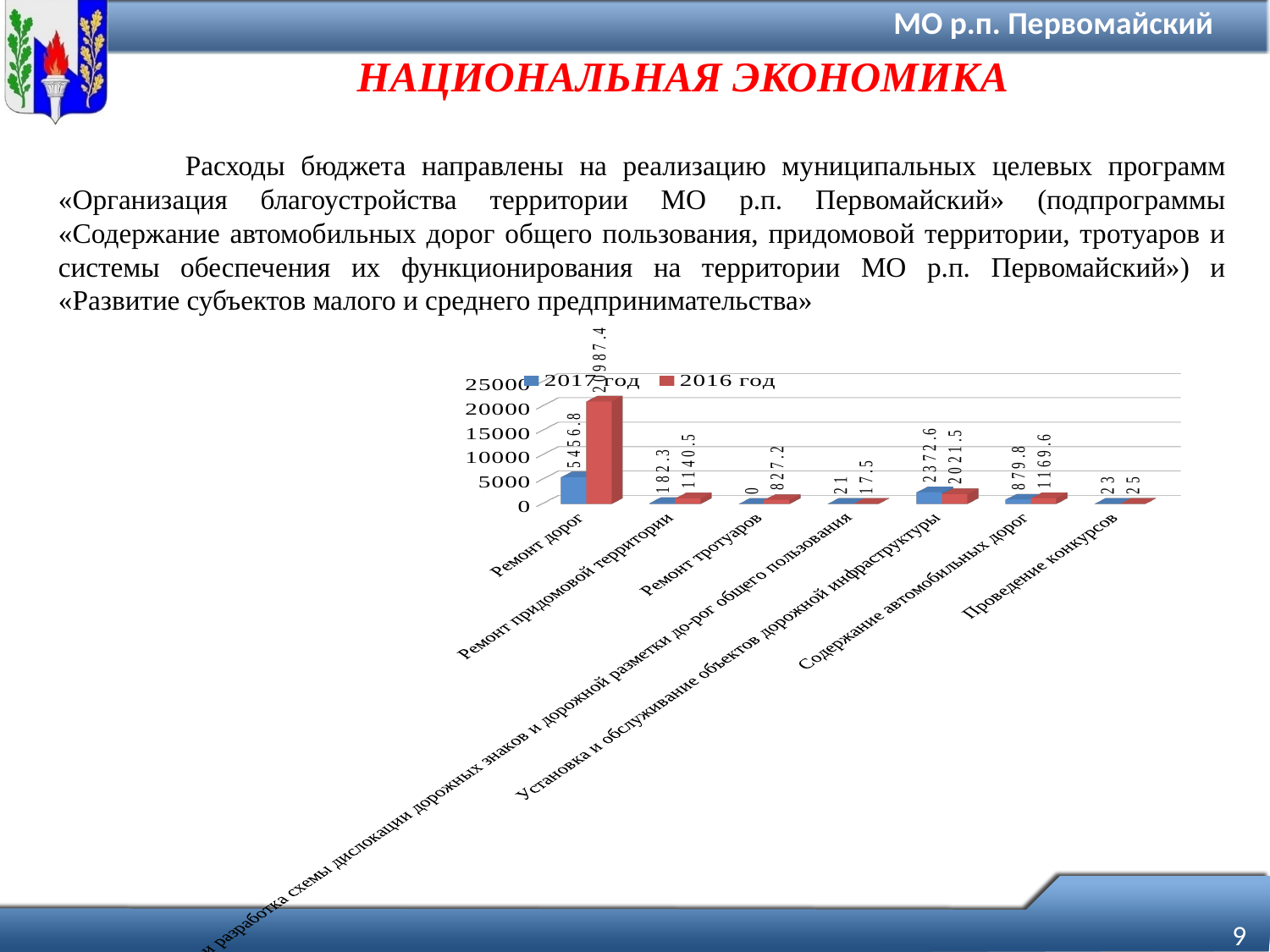
What is the 2017 год value for Ремонт тротуаров? 0 What is the 2017 год value for Ремонт дорог? 5456.8 What is the 2016 год value for Содержание автомобильных дорог? 1169.6 How many series does the chart legend list? 2 What kind of chart is shown on the slide? Bar chart How many categories are shown on the x axis of the chart? 7 What is the difference between the 2016 год and 2017 год values for Ремонт дорог? 15530.6 What is the 2017 год value for Установка и обслуживание объектов дорожной инфраструктуры? 2372.6 What is the 2016 год value for Ремонт дорог? 20987.4 For Установка и обслуживание объектов дорожной инфраструктуры, which year has the larger value, 2017 год or 2016 год? 2017 год Which category has the lowest 2017 год value? Ремонт тротуаров Which category has the highest 2016 год value? Ремонт дорог